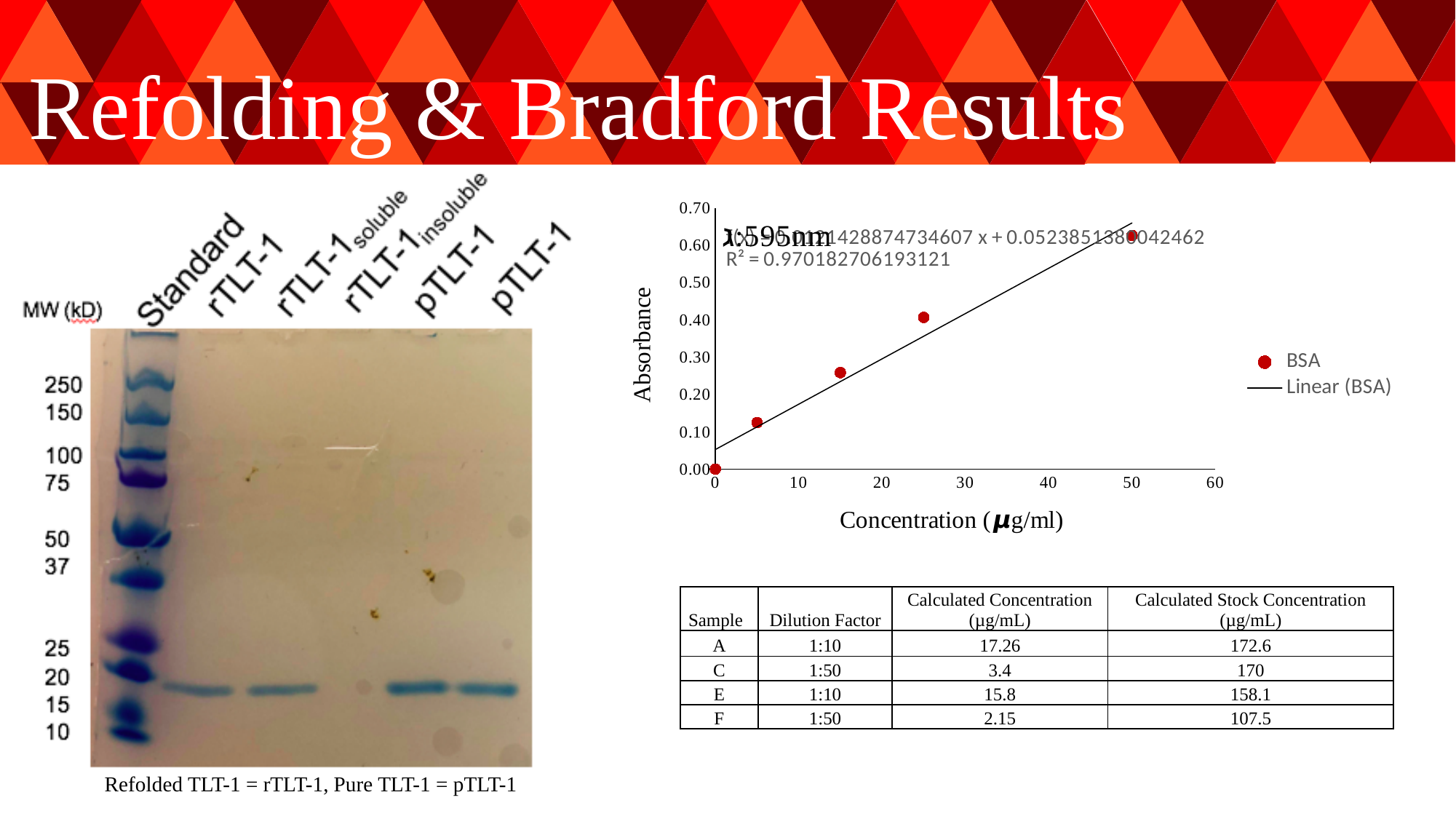
What kind of chart is shown on the right of the slide? scatter chart How many BSA data points are plotted on the scatter chart? 5 At which concentration is the BSA absorbance highest? 50 Is the BSA absorbance at a concentration of 5 greater or less than 0.20? less How many entries does the legend of the scatter chart list? 2 Which has the larger BSA absorbance: the point at concentration 25 or the point at concentration 15? 25 Is the BSA absorbance at a concentration of 50 greater or less than 0.50? greater Do the BSA absorbance values rise or fall as concentration increases along the x axis? rise What is the title of the x axis of the scatter chart? Concentration (μg/ml) What R² value is printed on the scatter chart for the linear fit? 0.970182706193121 Is the BSA absorbance at a concentration of 15 greater or less than 0.20? greater